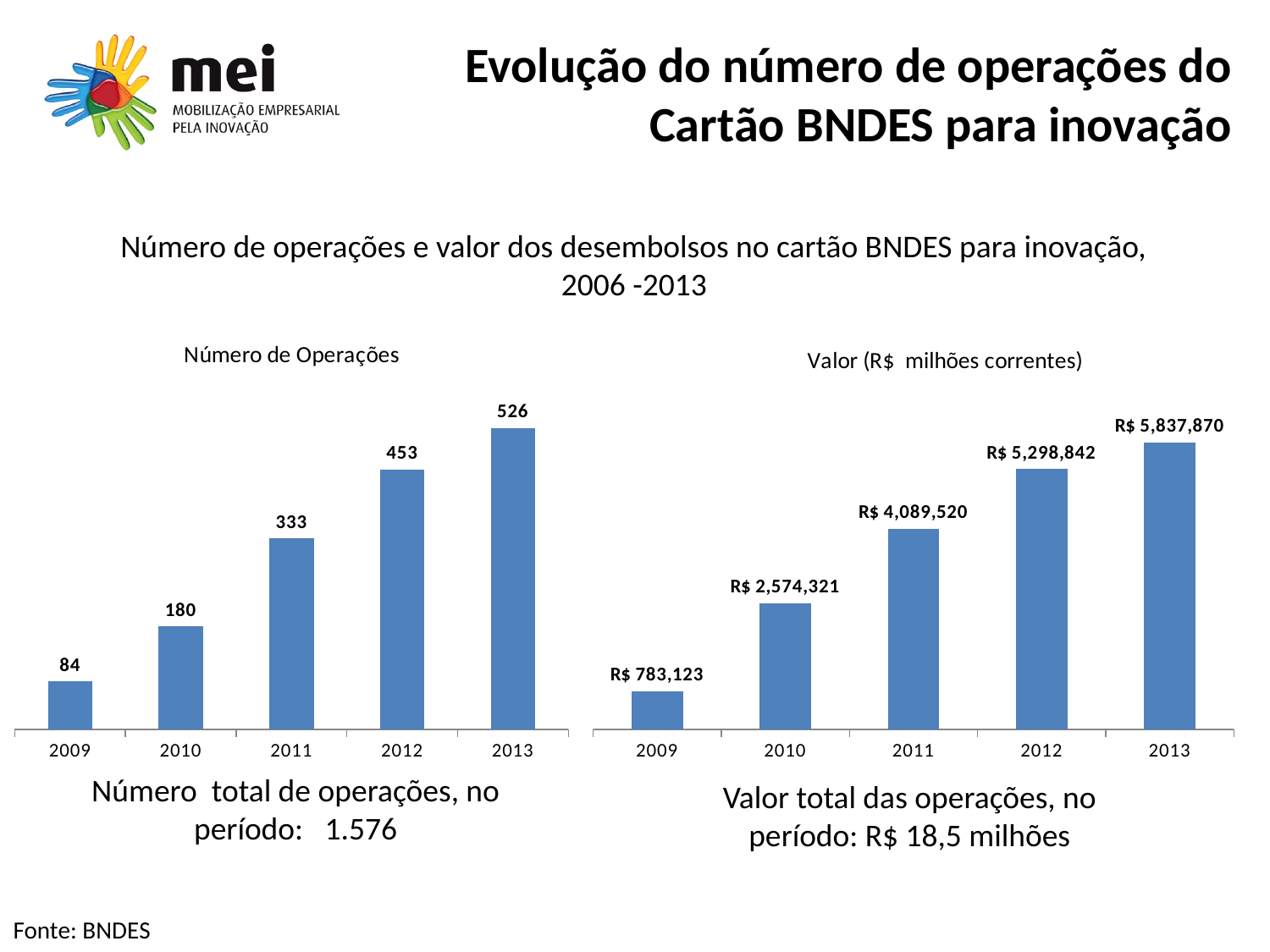
In the 'Número de Operações' chart, what is the difference between the values for 2010 and 2009? 96 In the 'Valor (R$ milhões correntes)' chart, which is larger, the value for 2011 or the value for 2010? 2011 In the 'Número de Operações' chart, what is the value for 2011? 333 What type of chart is the 'Valor (R$ milhões correntes)' chart? bar chart In the 'Número de Operações' chart, what is the value for 2009? 84 In the 'Valor (R$ milhões correntes)' chart, what is the value for 2010? R$ 2,574,321 How many years are shown in the 'Número de Operações' chart? 5 In the 'Número de Operações' chart, which year has the highest value? 2013 In the 'Valor (R$ milhões correntes)' chart, which year has the lowest value? 2009 In the 'Número de Operações' chart, what is the difference between the values for 2013 and 2012? 73 In the 'Valor (R$ milhões correntes)' chart, what is the value for 2012? R$ 5,298,842 In the 'Número de Operações' chart, do the values rise or fall from 2009 to 2013? rise